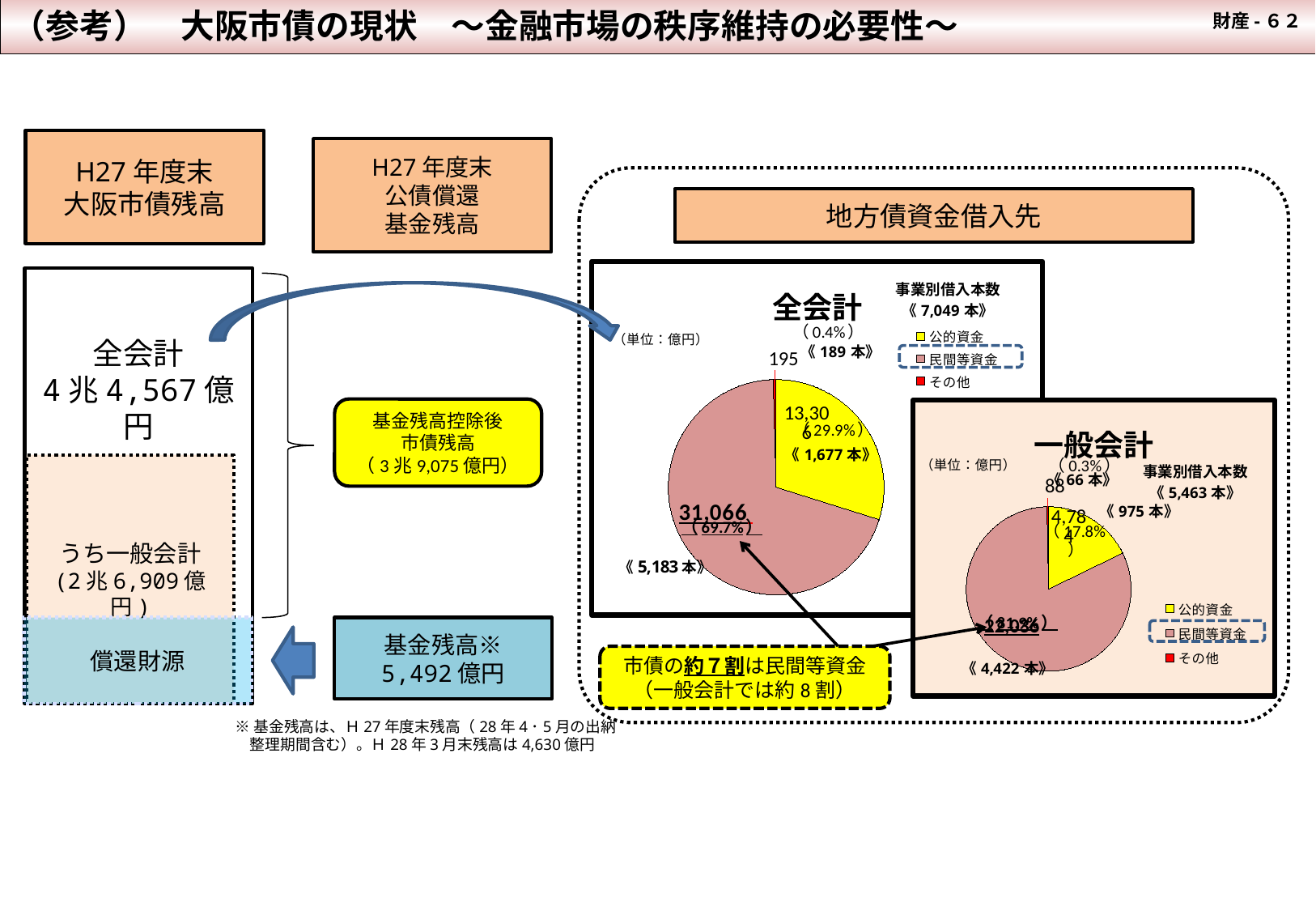
How many charts are shown inside the 地方債資金借入先 box? 2 What kind of chart is used for 全会計 in the 地方債資金借入先 section? pie chart In the 全会計 pie chart, what is the value (億円) for 民間等資金? 31,066 In the 全会計 pie chart, what share of the pie is 公的資金? 29.9% In the 全会計 pie chart, which category is the largest? 民間等資金 In the 全会計 pie chart, what is the value (億円) for その他? 195 In the 全会計 pie chart, what share of the pie is 民間等資金? 69.7% In the 全会計 pie chart, which category is the smallest? その他 In the 一般会計 pie chart, which category is the largest? 民間等資金 In the 全会計 pie chart, what is the difference between 民間等資金 (31,066) and 公的資金 (13,306)? 17,760 In the 全会計 pie chart, how many entries does the legend list? 3 In the 一般会計 pie chart, what is the value (億円) for その他? 88